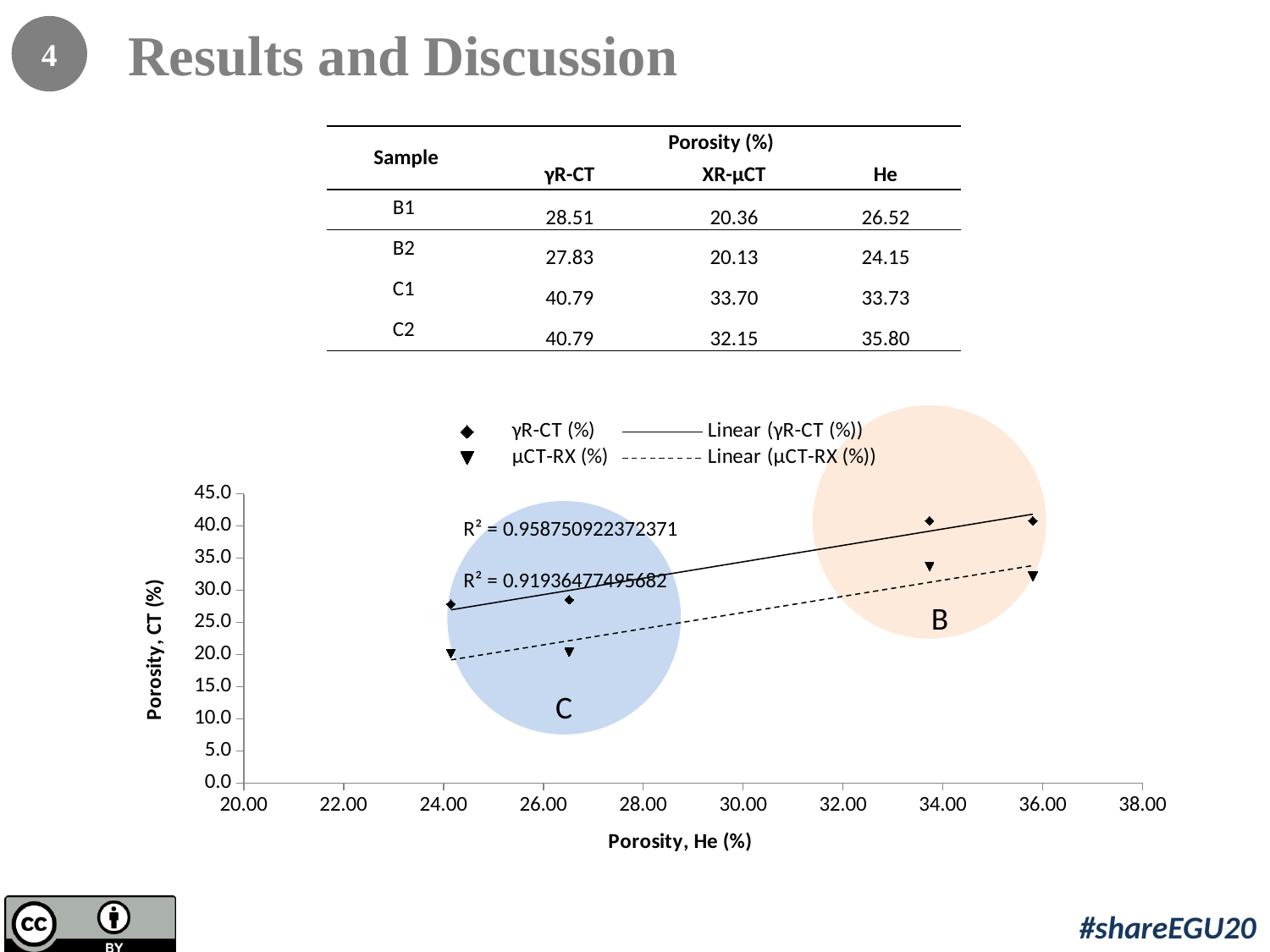
Is the μCT-RX (%) value at a He porosity of about 36% greater or less than 35.0? less What is the title of the y axis of the chart? Porosity, CT (%) What is the lower of the two R² values printed on the chart? 0.91936477495682 How many entries does the chart legend list? 4 What kind of chart is shown on the slide? Scatter chart What is the higher of the two R² values printed on the chart? 0.958750922372371 Is the μCT-RX (%) value at a He porosity of about 24% greater or less than 25.0? less At a He porosity of about 34%, which series has the larger CT porosity value, γR-CT (%) or μCT-RX (%)? γR-CT (%) Do the γR-CT (%) values rise or fall as He porosity increases along the x axis? rise Is the γR-CT (%) value at a He porosity of about 26.5% greater or less than 25.0? greater What is the title of the x axis of the chart? Porosity, He (%) How many data points are plotted for the γR-CT (%) series? 4